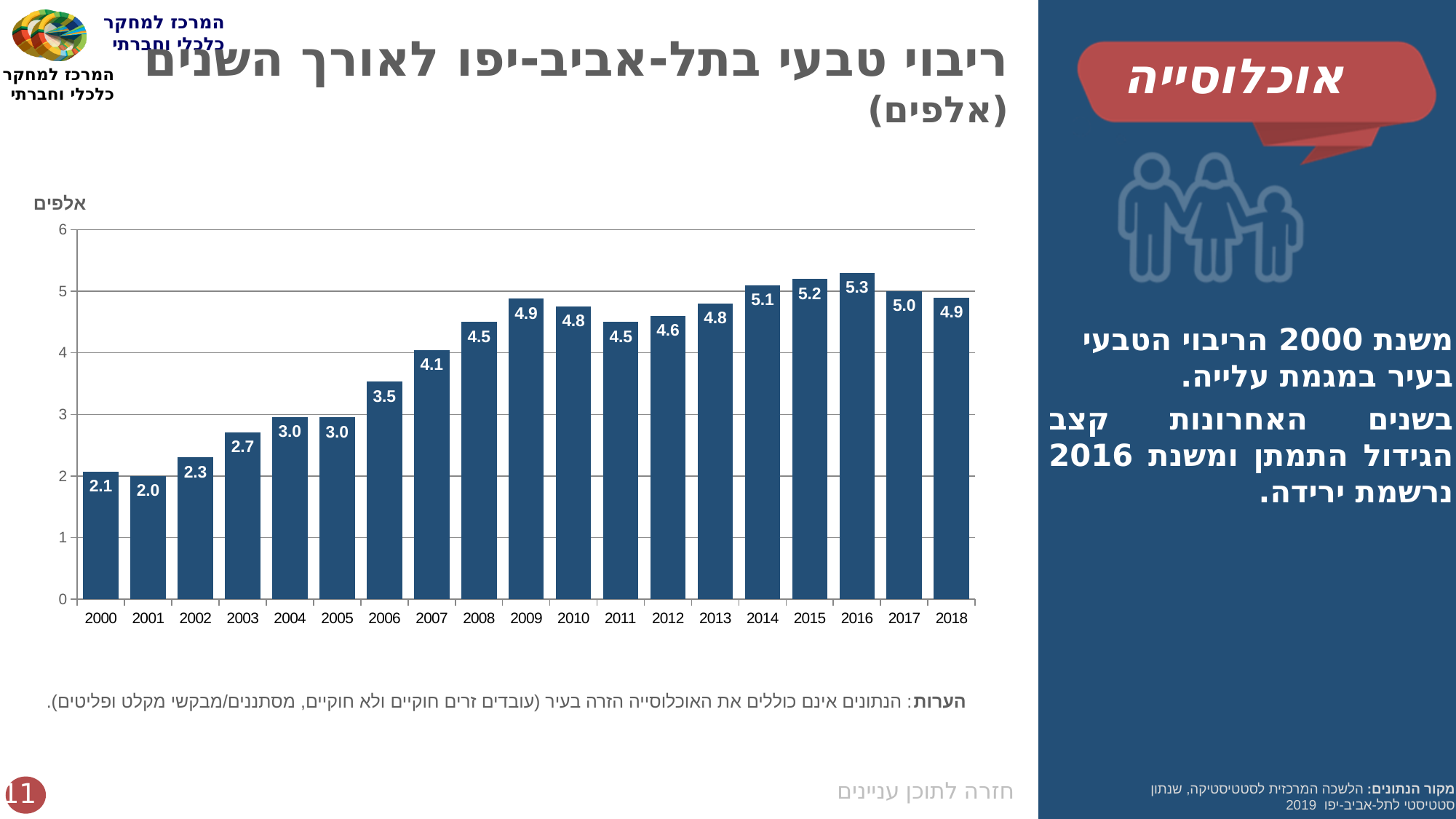
Which year has the lowest value? 2001 Which year has the highest value? 2016 What kind of chart is this? bar chart How many years are shown on the x axis? 19 What is the difference between the values for 2016 and 2000? 3.2 What is the value for 2000? 2.1 What is the value for 2018? 4.9 What is the value for 2007? 4.1 What is the value for 2016? 5.3 Which is larger, the value for 2009 or the value for 2011? 2009 Do the values generally rise or fall from 2000 to 2016? rise What is the difference between the values for 2018 and 2017? 0.1